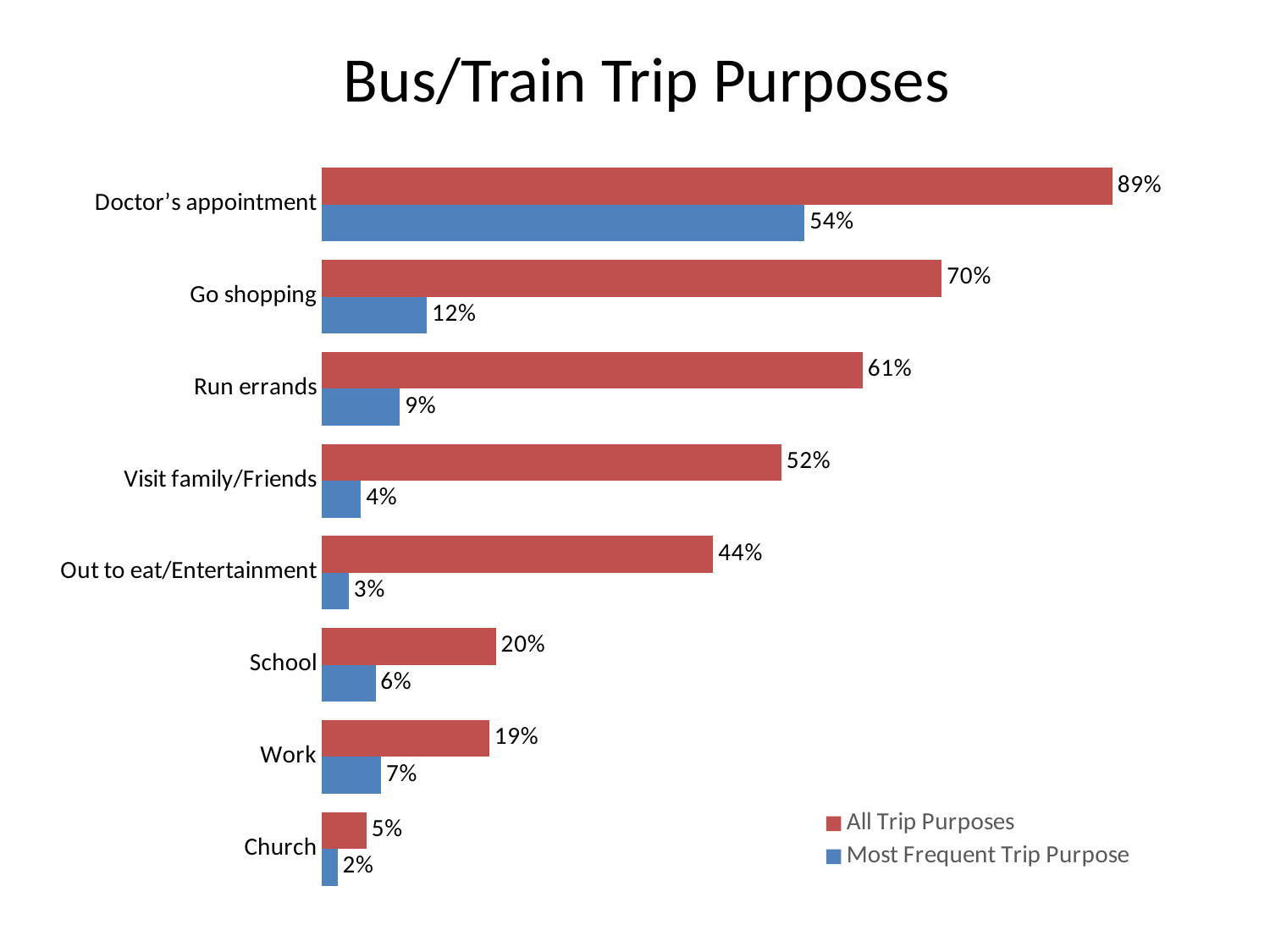
What kind of chart is shown on the slide? Bar chart What is the title of the chart? Bus/Train Trip Purposes How many series does the legend list? 2 Which category has the lowest value in the All Trip Purposes series? Church How many categories are shown on the chart? 8 What is the value for Work in the All Trip Purposes series? 19% Which is larger: the Most Frequent Trip Purpose value for School or for Work? Work What is the value for Doctor's appointment in the All Trip Purposes series? 89% Which category has the highest value in the Most Frequent Trip Purpose series? Doctor's appointment What is the value for Go shopping in the Most Frequent Trip Purpose series? 12% Which colour represents the Most Frequent Trip Purpose series? Blue What is the difference between the All Trip Purposes value and the Most Frequent Trip Purpose value for Run errands? 52%